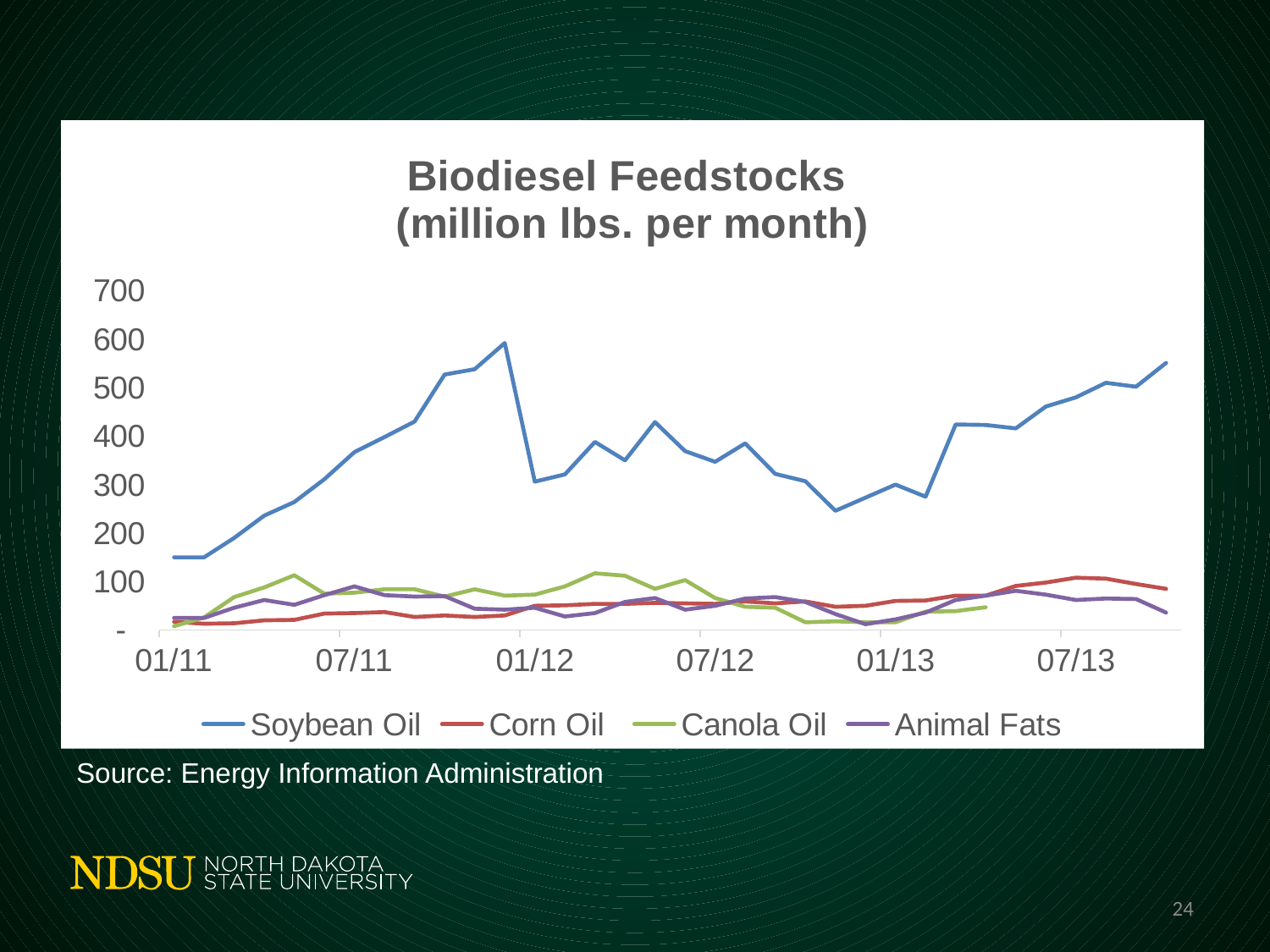
What is the title of the chart? Biodiesel Feedstocks (million lbs. per month) What kind of chart is shown on the slide? line chart At 07/13, which is larger: Soybean Oil or Corn Oil? Soybean Oil How many series does the legend list? 4 Does the Soybean Oil line rise or fall between 01/11 and 07/11? rise Is the value for Corn Oil at 07/13 greater or less than 200? less Is the value for Soybean Oil at 01/13 greater or less than 400? less Does the Soybean Oil line rise or fall from 07/13 to the end of the series? rise Is the value for Soybean Oil at 01/11 greater or less than 200? less Which series has the highest values across the whole period? Soybean Oil What colour is the Soybean Oil line in the legend? blue